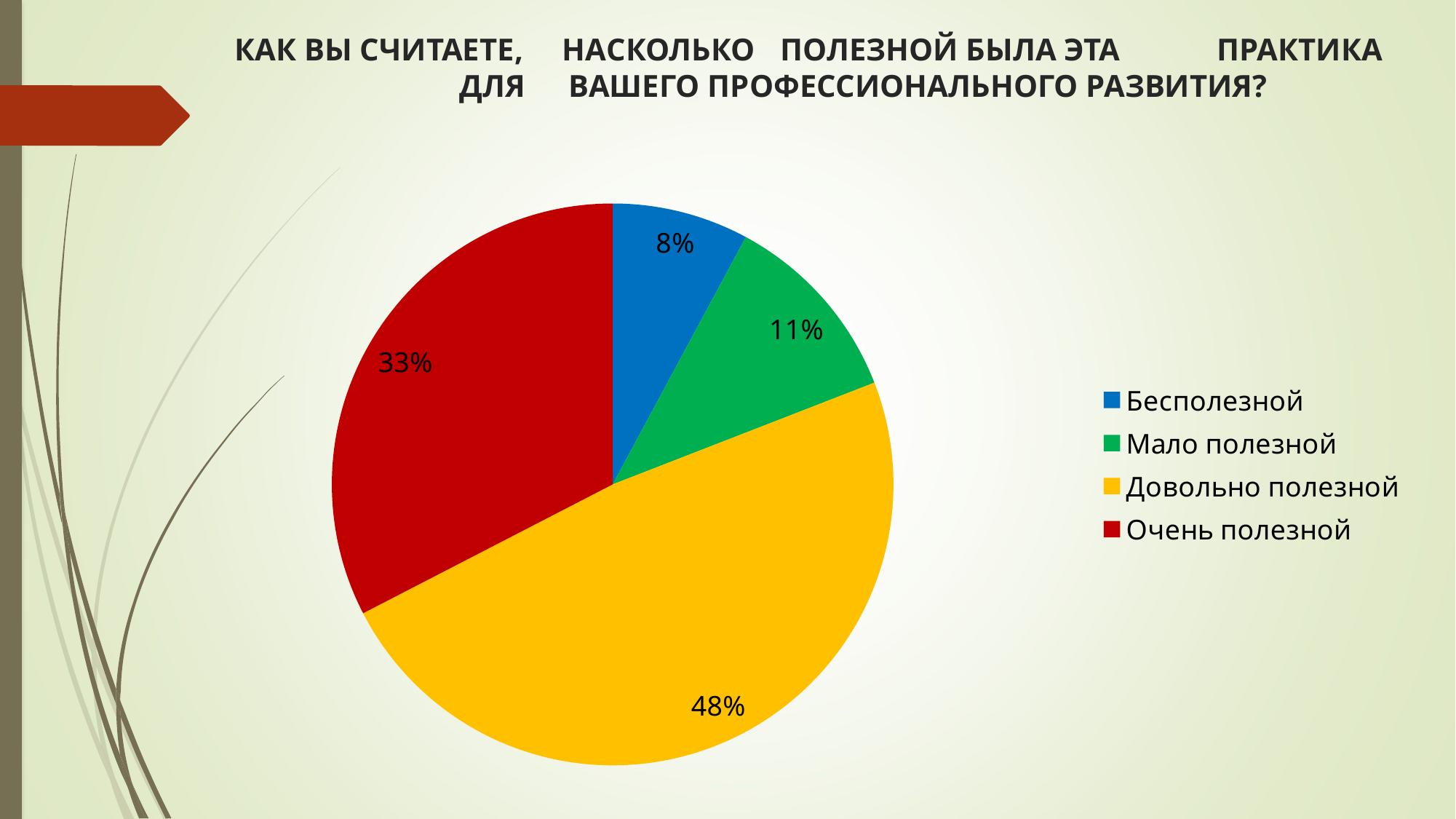
What is the difference in percentage points between "Довольно полезной" and "Очень полезной"? 15 What share of the pie does "Мало полезной" take? 11% What share of the pie does "Бесполезной" take? 8% Which is larger, the slice for "Мало полезной" or the slice for "Бесполезной"? Мало полезной Which category has the smallest slice of the pie? Бесполезной What share of the pie does "Очень полезной" take? 33% What kind of chart is shown on the slide? pie chart Which category has the largest slice of the pie? Довольно полезной What colour is the slice for "Очень полезной"? red Which legend entry is shown in blue? Бесполезной How many categories does the pie chart have? 4